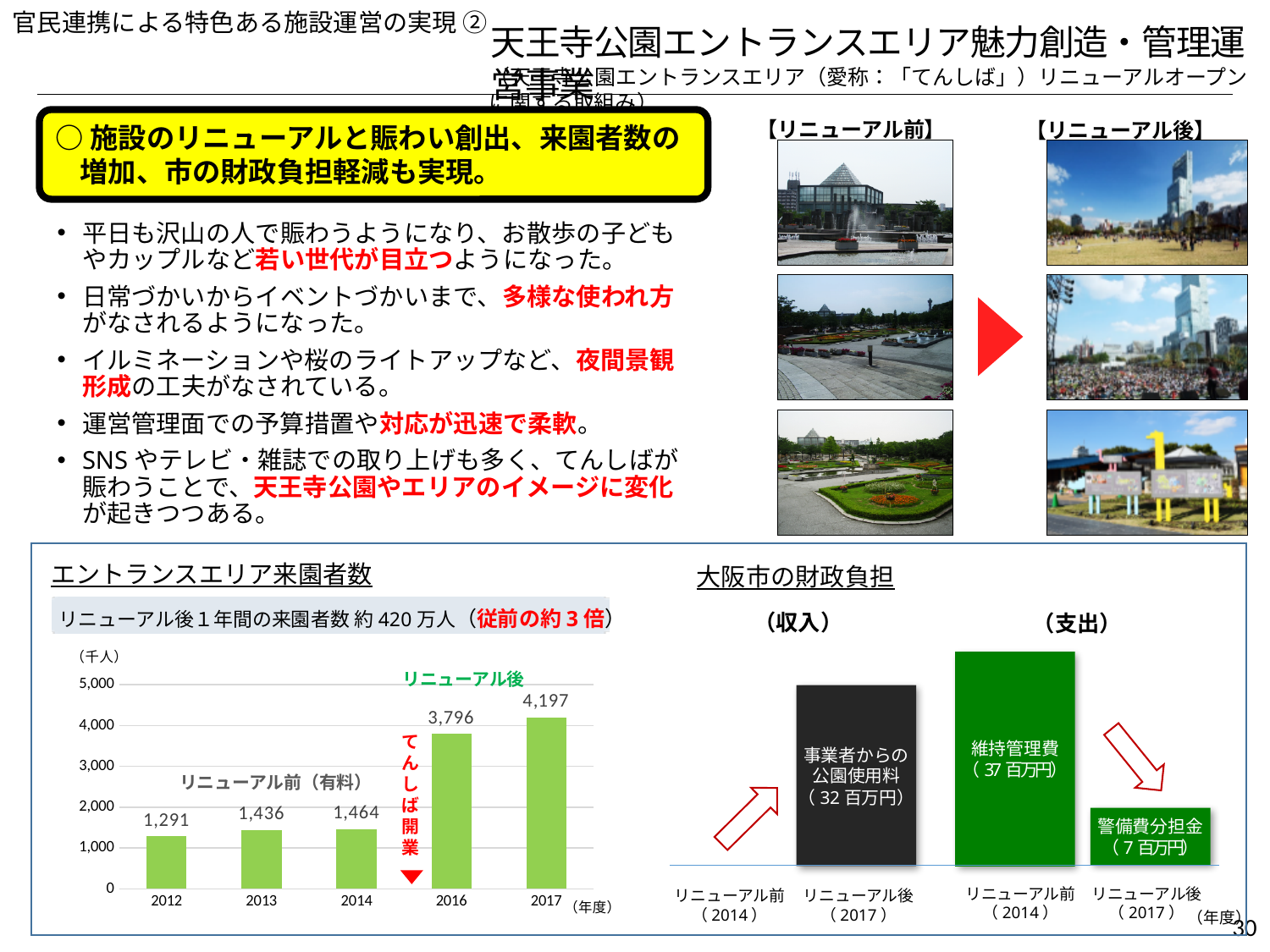
In the エントランスエリア来園者数 chart, what is the difference between the values for 2014 and 2012? 173 How many years are plotted in the エントランスエリア来園者数 chart? 5 In the エントランスエリア来園者数 chart, which is larger, the value for 2013 or the value for 2016? 2016 In the エントランスエリア来園者数 chart, what is the difference between the values for 2017 and 2016? 401 In the エントランスエリア来園者数 chart, what is the value for 2012? 1,291 In the 大阪市の財政負担 diagram, what is the amount shown for 維持管理費 in リニューアル前（2014）? 37百万円 In the エントランスエリア来園者数 chart, which year has the highest value? 2017 In the エントランスエリア来園者数 chart, do the values rise or fall from 2012 to 2017? rise In the エントランスエリア来園者数 chart, what is the value for 2017? 4,197 In the エントランスエリア来園者数 chart, what is the value for 2016? 3,796 In the エントランスエリア来園者数 chart, which year has the lowest value? 2012 What kind of chart is the エントランスエリア来園者数 chart? bar chart